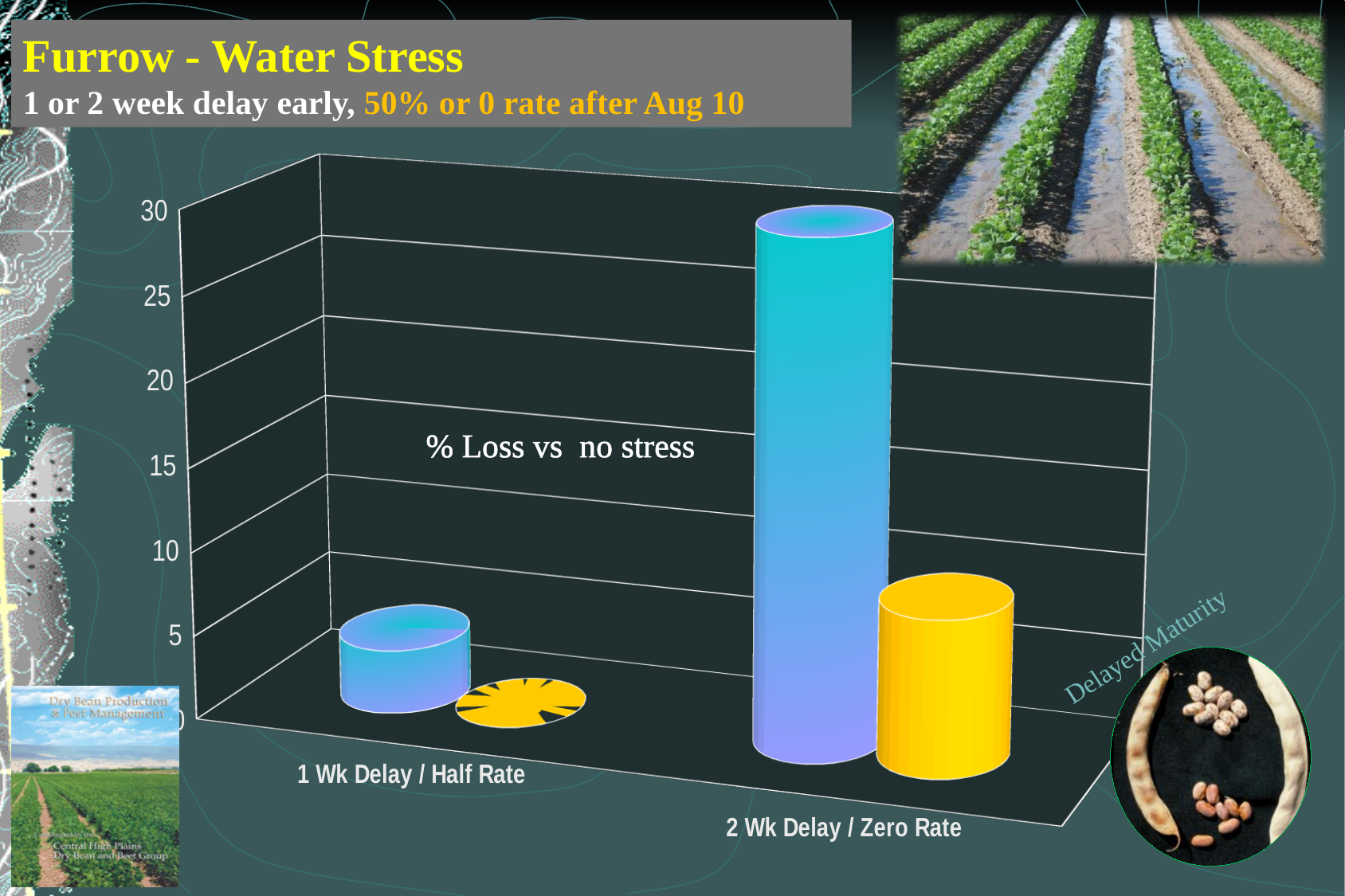
Which is larger: the blue bar for 1 Wk Delay / Half Rate or the blue bar for 2 Wk Delay / Zero Rate? 2 Wk Delay / Zero Rate What is the highest value shown on the chart's vertical axis? 30 Is the value of the yellow bar for 1 Wk Delay / Half Rate greater or less than 5? less What text label is printed inside the chart's plot area? % Loss vs no stress How many categories are shown on the x axis of the chart? 2 What kind of chart is shown on the slide? bar chart Do the bar values rise or fall from 1 Wk Delay / Half Rate to 2 Wk Delay / Zero Rate? rise Is the value of the tallest blue bar (2 Wk Delay / Zero Rate) greater or less than 25? greater Is the value of the yellow bar for 2 Wk Delay / Zero Rate greater or less than 5? greater What are the two category labels on the x axis of the chart? 1 Wk Delay / Half Rate; 2 Wk Delay / Zero Rate Which category has the tallest bar in the chart? 2 Wk Delay / Zero Rate